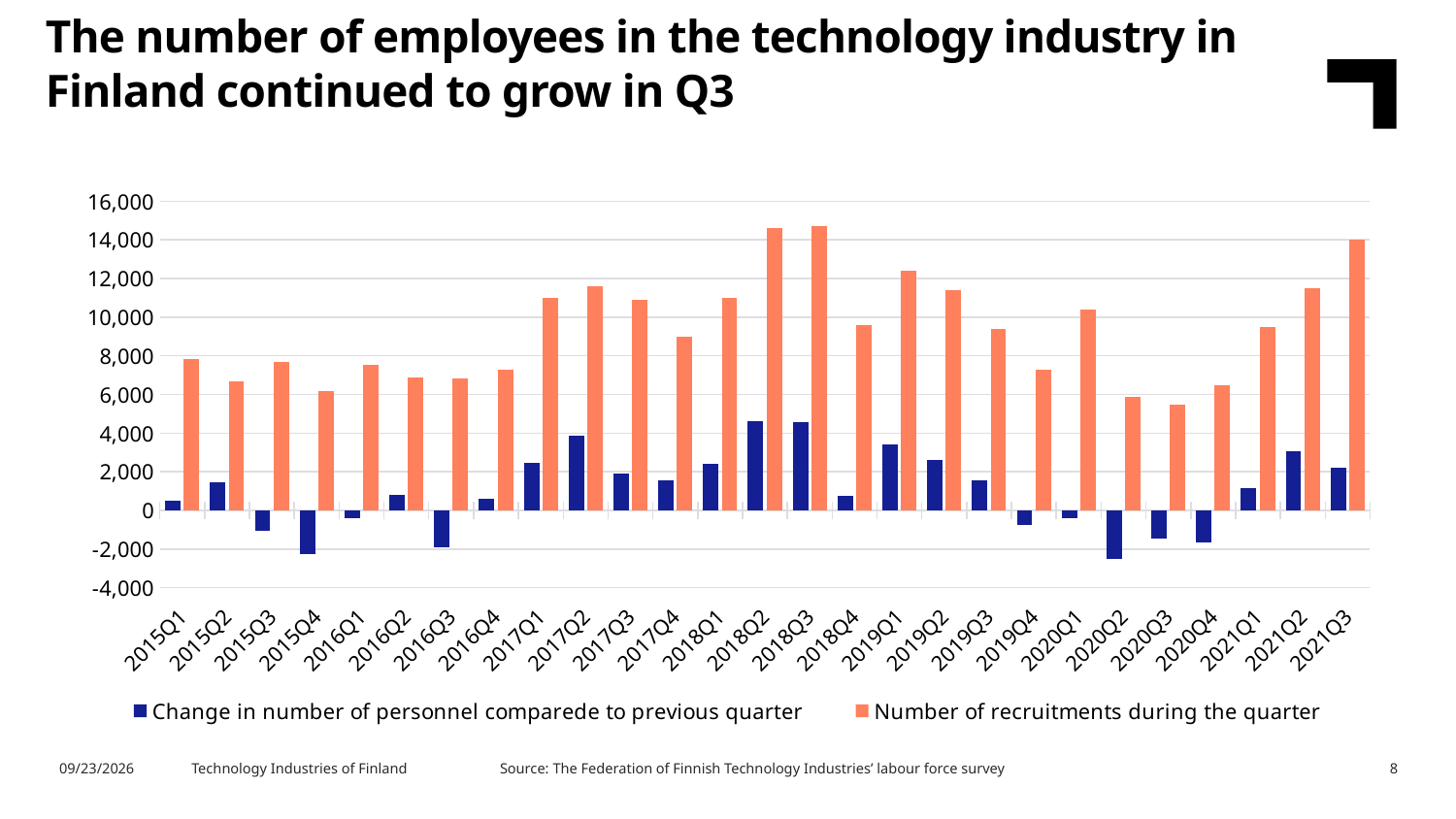
Which is larger, the number of recruitments during the quarter in 2018Q2 or in 2015Q1? 2018Q2 How many quarters are shown on the x axis? 27 Which is larger, the change in number of personnel compared to previous quarter in 2017Q2 or in 2016Q1? 2017Q2 What kind of chart is shown on the slide? bar chart Is the number of recruitments during the quarter for 2021Q3 greater or less than 12,000? greater Is the number of recruitments during the quarter for 2020Q3 greater or less than 6,000? less Is the change in number of personnel compared to previous quarter for 2017Q2 greater or less than 2,000? greater How many series does the legend list? 2 What colour are the bars for the number of recruitments during the quarter? orange Do the number of recruitments during the quarter rise or fall from 2020Q3 to 2021Q3? rise